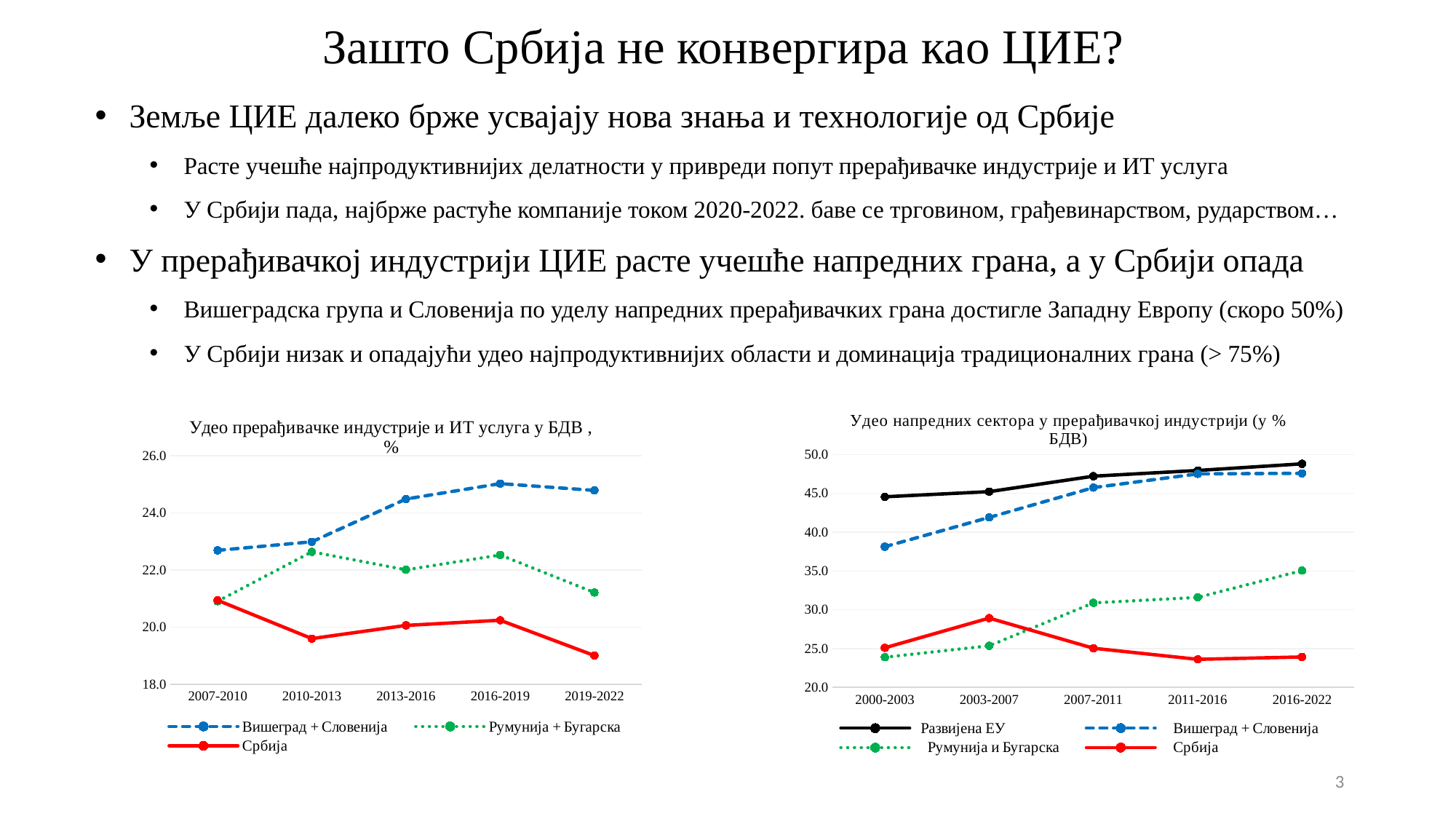
In the right chart, which series has the highest value in 2000-2003? Развијена ЕУ In the left chart, does the value for Србија rise or fall from 2016-2019 to 2019-2022? fall In the right chart, is the value for Вишеград + Словенија in 2000-2003 greater or less than 40.0? less How many series does the legend of the left chart list? 3 In the right chart, does the value for Румунија и Бугарска rise or fall from 2000-2003 to 2016-2022? rise In the right chart, is the value for Србија in 2011-2016 greater or less than 25.0? less How many periods are shown on the x axis of the left chart? 5 In the left chart, is the value for Србија in 2019-2022 greater or less than 20.0? less What kind of chart is the left chart, 'Удео прерађивачке индустрије и ИТ услуга у БДВ, %'? line chart In the left chart, which series has the lowest value in 2019-2022? Србија How many series does the legend of the right chart, 'Удео напредних сектора у прерађивачкој индустрији', list? 4